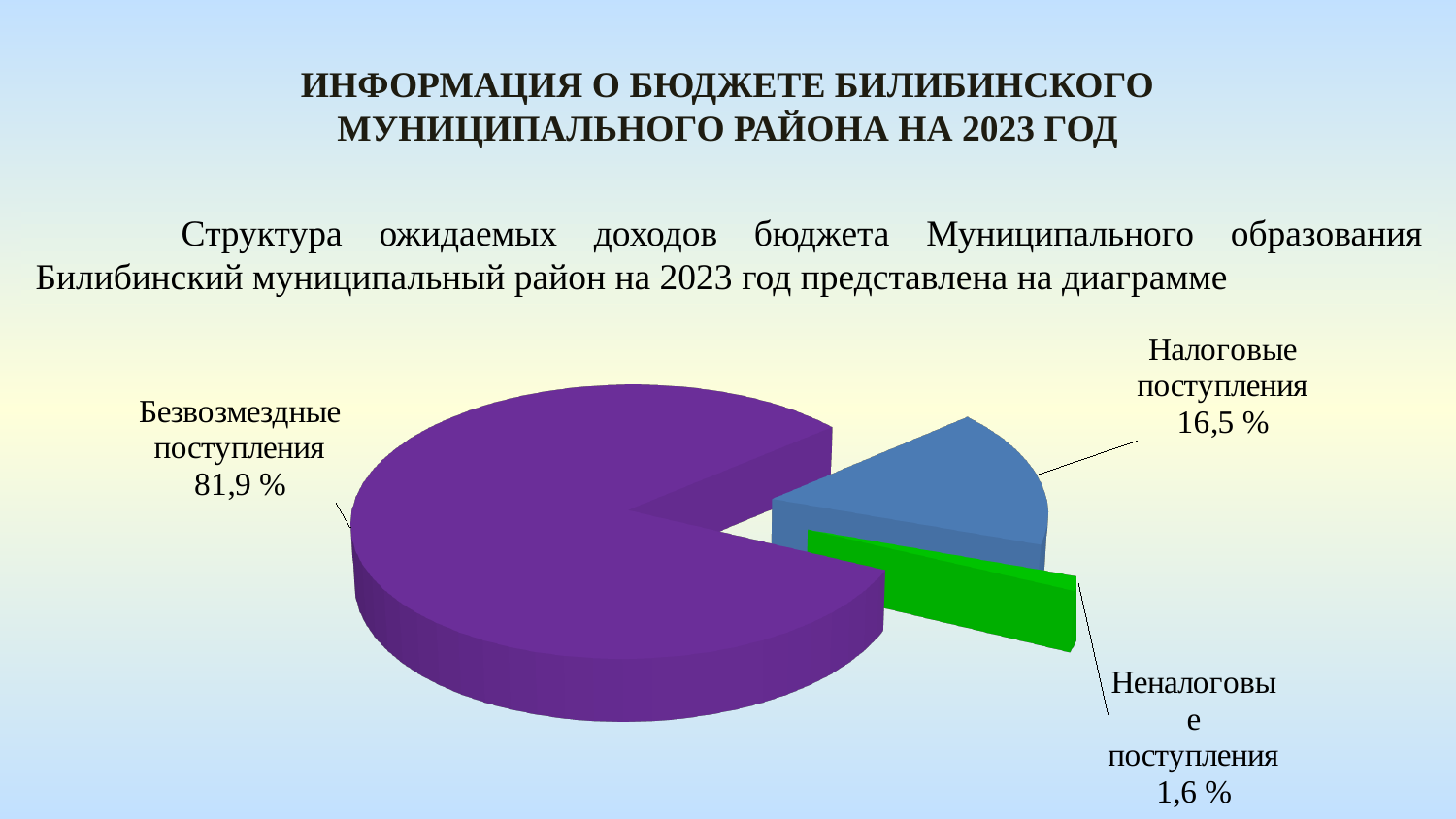
What colour is the slice for Неналоговые поступления? Green What share of the pie is labelled for Налоговые поступления? 16,5 % Which category has the smallest slice of the pie? Неналоговые поступления Which is larger: the share for Налоговые поступления or the share for Неналоговые поступления? Налоговые поступления Which category has the largest slice of the pie? Безвозмездные поступления What colour is the slice for Безвозмездные поступления? Purple What is the difference in percentage points between Налоговые поступления and Неналоговые поступления? 14,9 What kind of chart is shown on the slide? Pie chart What is the difference in percentage points between Безвозмездные поступления and Налоговые поступления? 65,4 How many slices does the pie chart have? 3 What share of the pie is labelled for Неналоговые поступления? 1,6 % What share of the pie is labelled for Безвозмездные поступления? 81,9 %